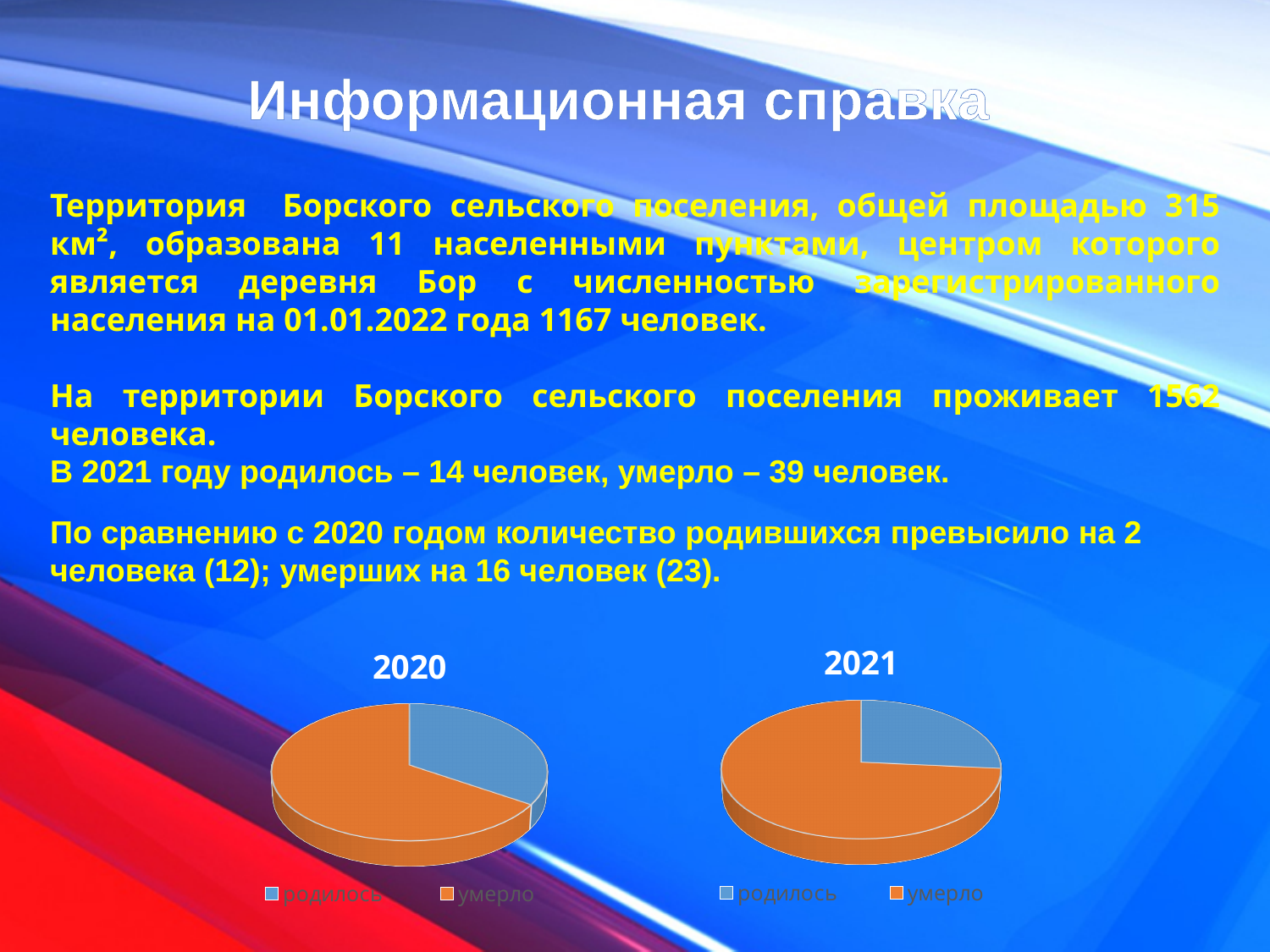
What is the title of the pie chart on the left? 2020 In the chart titled 2021, which slice is larger, родилось or умерло? умерло In the chart titled 2021, how many slices does the pie have? 2 What kind of chart is the chart titled 2020? pie chart In the chart titled 2020, how many entries does the legend list? 2 In the chart titled 2021, which category has the smallest slice? родилось In the chart titled 2021, what colour is the умерло slice? orange In the chart titled 2020, which slice is larger, родилось or умерло? умерло In the chart titled 2020, which category has the largest slice? умерло What kind of chart is the chart titled 2021? pie chart